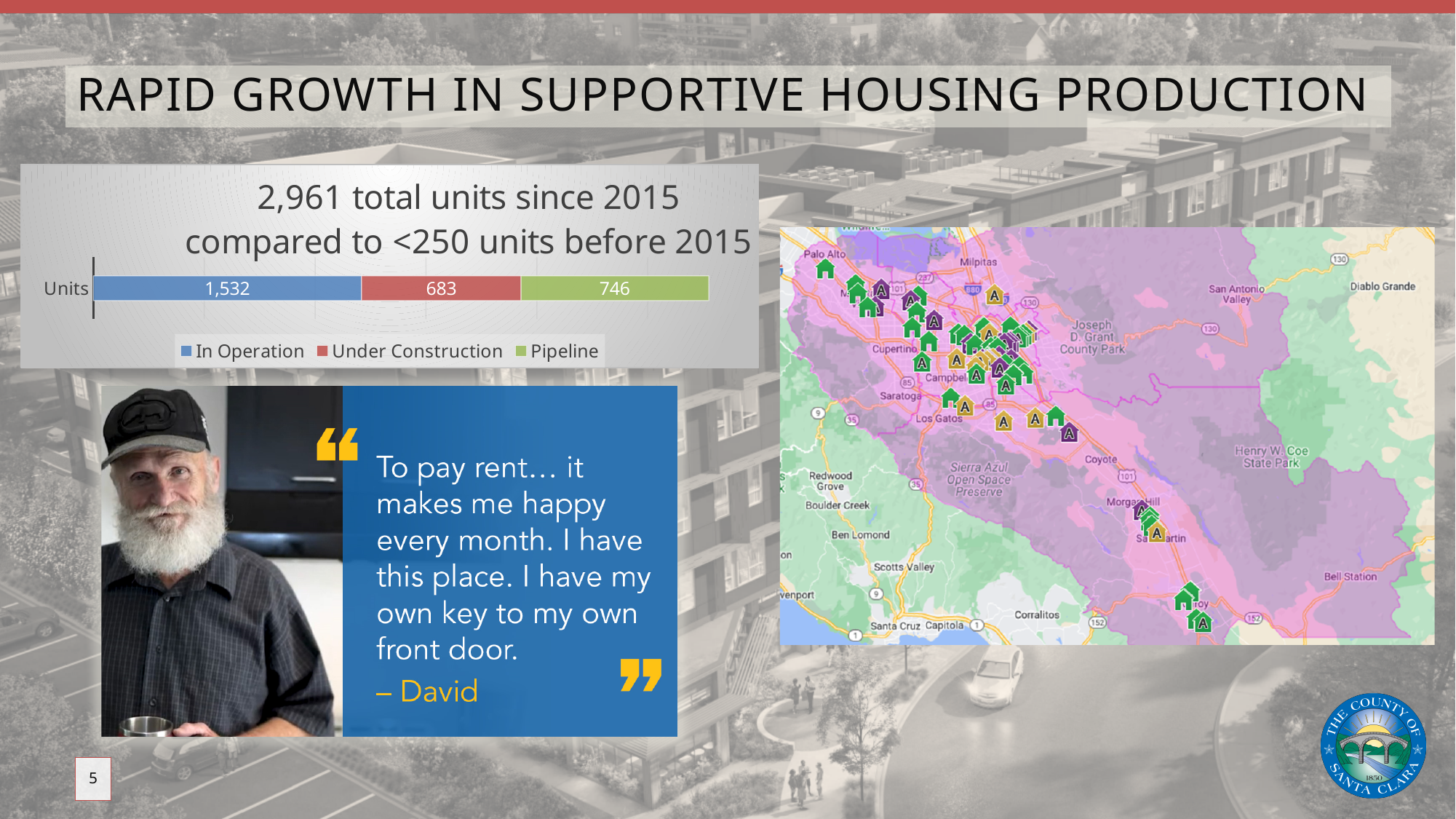
Which series has the largest number of units in the chart? In Operation How many units are In Operation according to the chart? 1,532 What colour represents Under Construction in the chart? Red Which series has the smallest number of units in the chart? Under Construction What is the total of the stacked Units bar? 2,961 What kind of chart is used to show the units? Stacked bar chart What is the difference between the Pipeline units and the Under Construction units? 63 What is the difference between the In Operation units and the Pipeline units? 786 Which is larger, the Pipeline units or the Under Construction units? Pipeline How many units are Under Construction according to the chart? 683 How many series does the chart legend list? 3 How many units are in the Pipeline according to the chart? 746